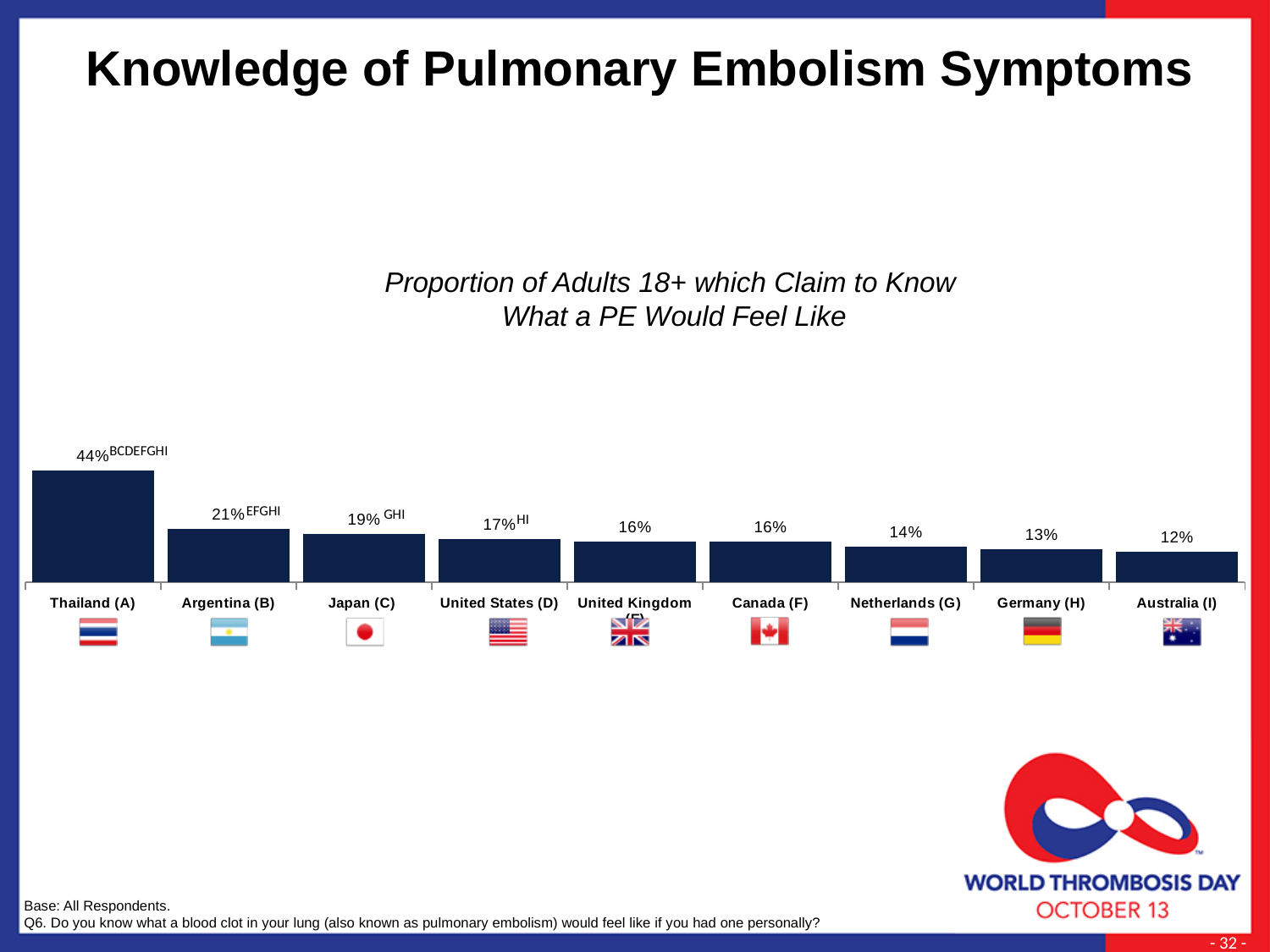
What is the value for Netherlands (G)? 14% Which country has the lowest value on the chart? Australia (I) What kind of chart is shown on the slide? Bar chart What is the value for Japan (C)? 19% How many countries are shown on the chart? 9 Which country has the highest proportion of adults claiming to know what a PE would feel like? Thailand (A) What is the subtitle of the chart? Proportion of Adults 18+ which Claim to Know What a PE Would Feel Like What is the difference between the values for United States (D) and Germany (H)? 4% Which is larger, the value for Argentina (B) or the value for Canada (F)? Argentina (B) What is the value for Thailand (A)? 44% Do the values rise or fall moving from left to right across the chart? Fall What is the difference between the values for Thailand (A) and Argentina (B)? 23%